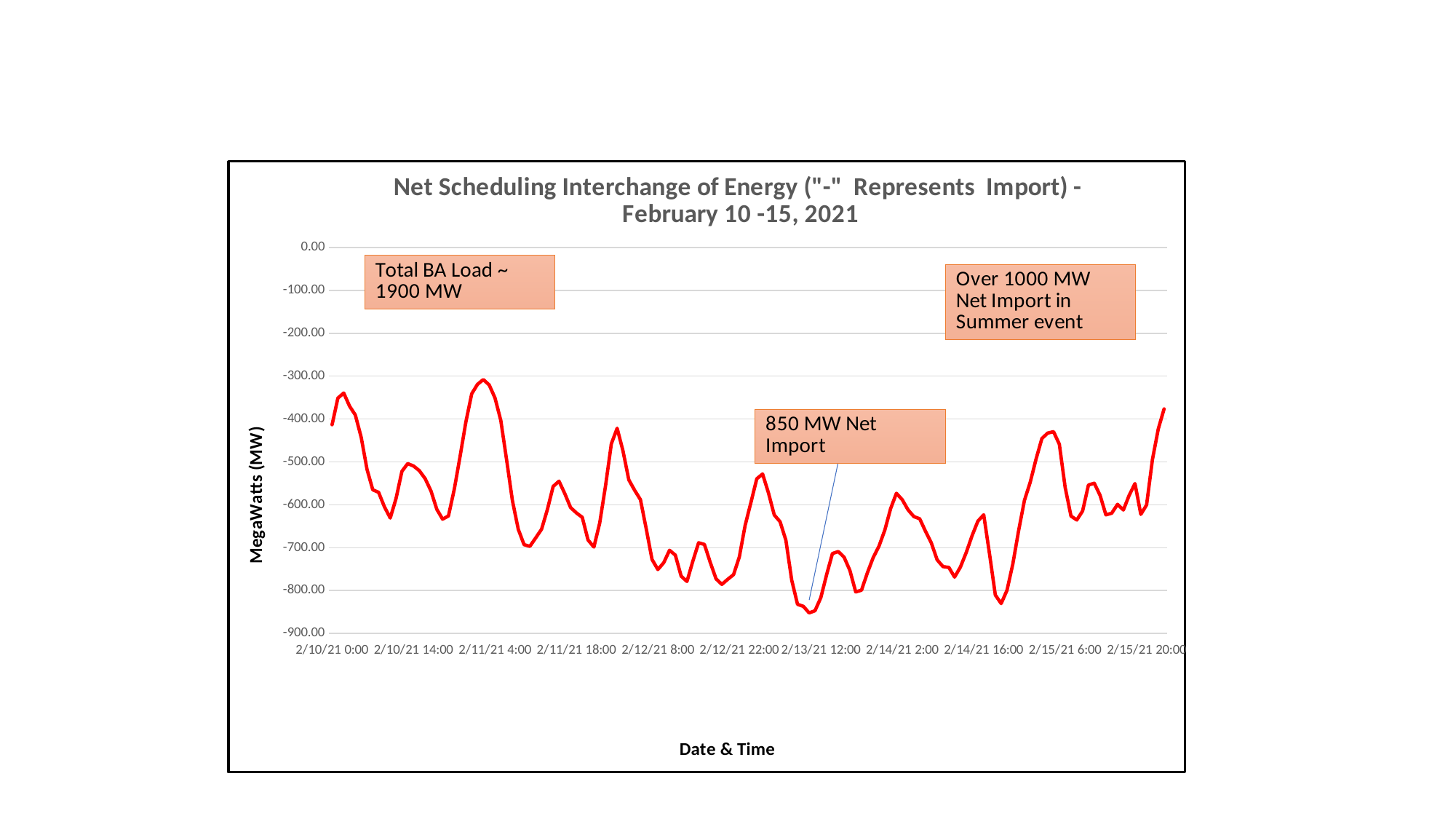
What kind of chart is shown on the slide? line chart Near which x-axis label does the line reach its highest value? 2/11/21 4:00 What is the label of the vertical axis? MegaWatts (MW) Is the value at 2/13/21 12:00 greater or less than -800.00? less What is the title of the chart? Net Scheduling Interchange of Energy ("-" Represents Import) - February 10 -15, 2021 How many date/time labels are shown on the x axis? 11 Which is larger, the value at 2/11/21 4:00 or the value at 2/13/21 12:00? 2/11/21 4:00 Is the value at 2/11/21 4:00 greater or less than -400.00? greater According to the annotation, how much net import occurred in the Summer event? Over 1000 MW What net import value does the annotation pointing to the low point near 2/13/21 12:00 state? 850 MW Net Import According to the annotation on the chart, what is the Total BA Load? ~ 1900 MW